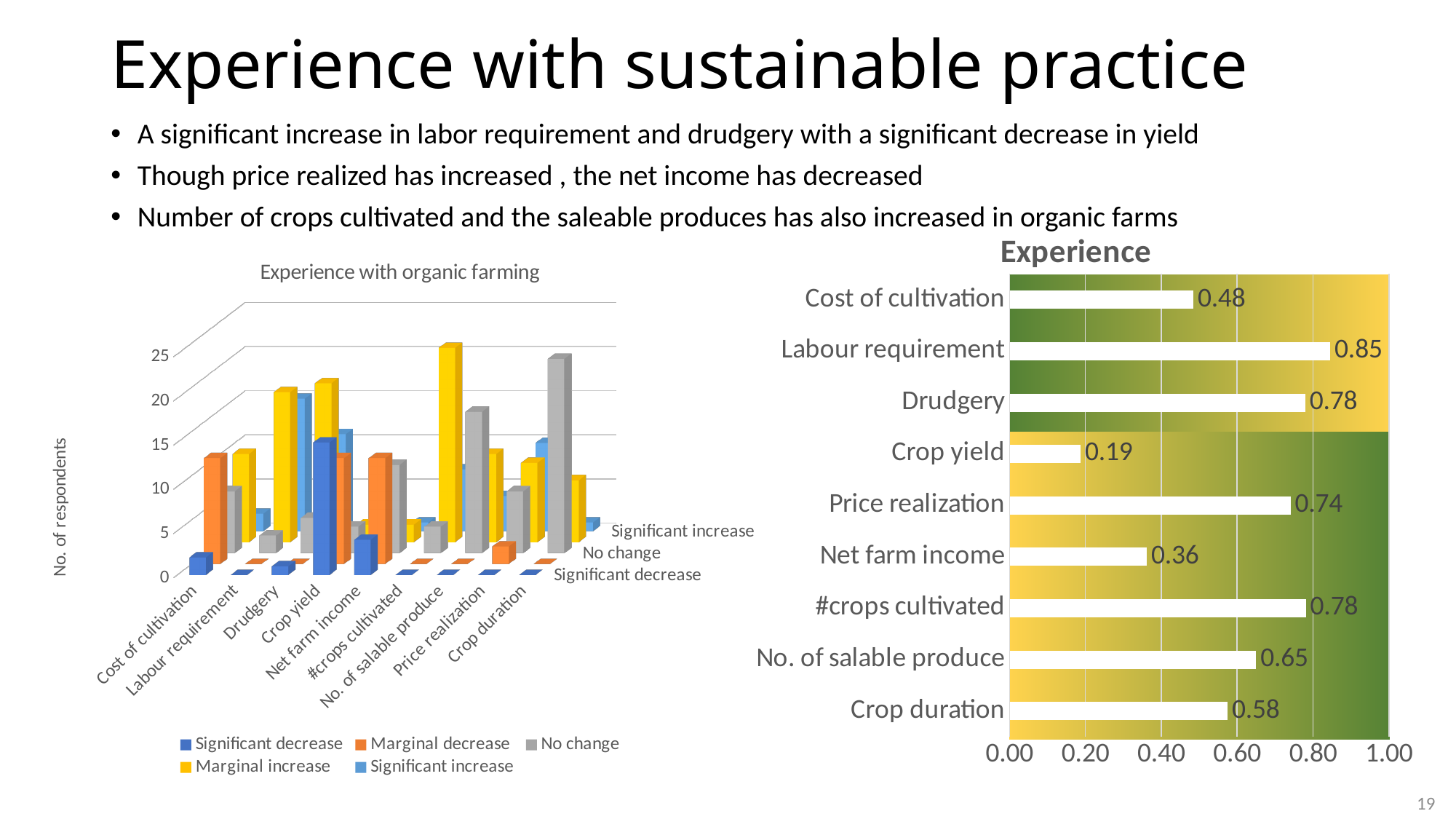
In the 'Experience' chart, what is the difference between the values for Labour requirement and Cost of cultivation? 0.37 In the 'Experience' chart, what is the value for Net farm income? 0.36 In the 'Experience' chart, which is larger: the value for Price realization or the value for Crop duration? Price realization In the 'Experience' chart, what is the value for No. of salable produce? 0.65 What kind of chart is the 'Experience' chart on the right? Bar chart In the 'Experience' chart, which category has the lowest value? Crop yield In the 'Experience' chart, what is the value for Crop yield? 0.19 How many categories are shown in the 'Experience' chart? 9 In the 'Experience' chart, which category has the highest value? Labour requirement In the 'Experience' chart, what is the value for Labour requirement? 0.85 What is the y-axis label of the 'Experience with organic farming' chart? No. of respondents How many series does the legend of the 'Experience with organic farming' chart list? 5